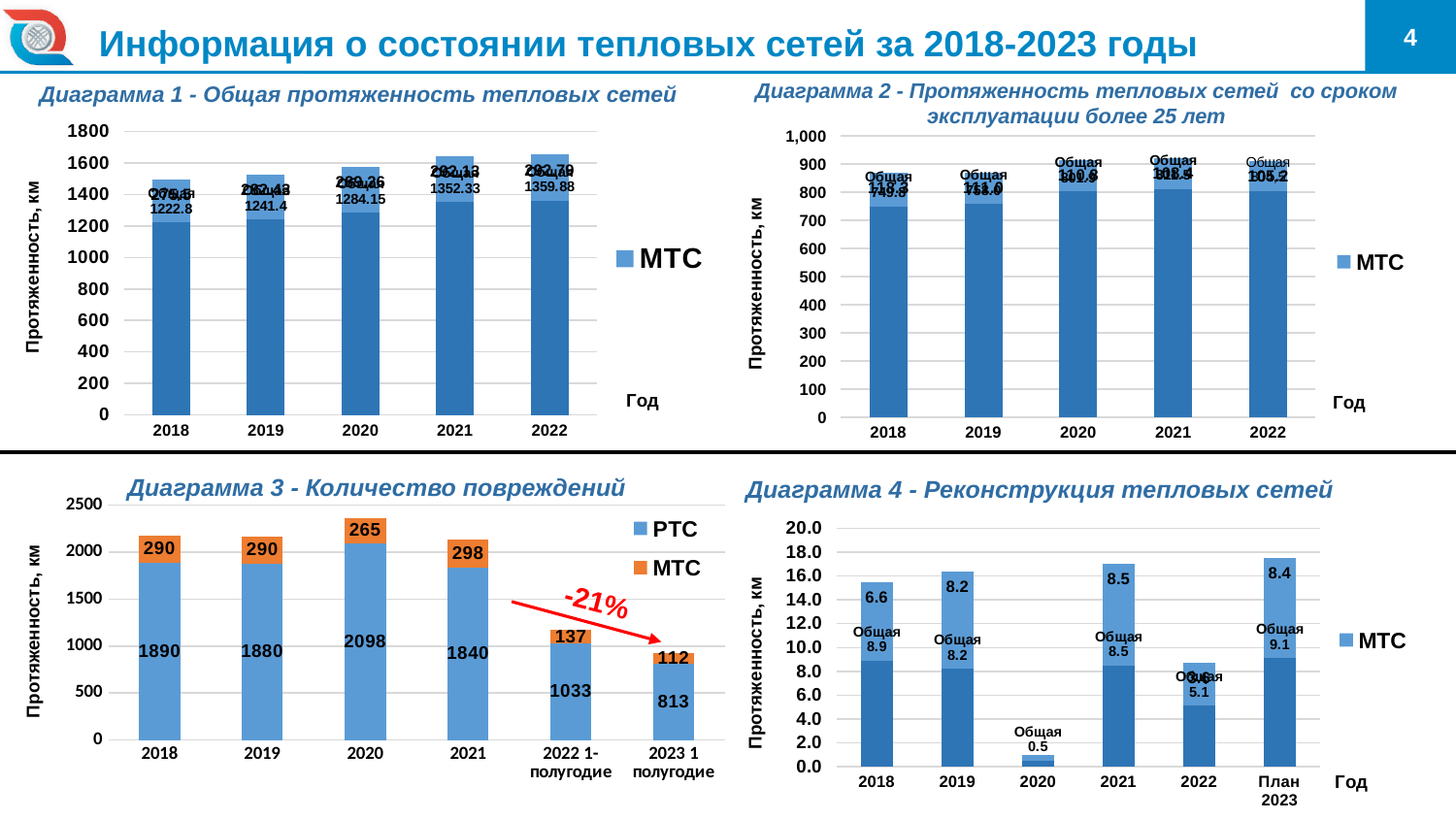
In Diagram 3 (Количество повреждений), what is the РТС value for 2020? 2098 In Diagram 3 (Количество повреждений), how many categories are shown on the x axis? 6 In Diagram 3 (Количество повреждений), what is the difference between the РТС values for 2018 and 2019? 10 In Diagram 1 (Общая протяженность тепловых сетей), do the lower data label values rise or fall from 2018 to 2022? rise In Diagram 3 (Количество повреждений), what is the МТС value for 2021? 298 In Diagram 3 (Количество повреждений), which category has the highest РТС value? 2020 In Diagram 2 (Протяженность тепловых сетей со сроком эксплуатации более 25 лет), is the bar for 2018 greater or less than 700? greater In Diagram 1 (Общая протяженность тепловых сетей), what is the lower data label value for 2021? 1352.33 In Diagram 4 (Реконструкция тепловых сетей), what is the 'Общая' value for 2020? 0.5 In Diagram 3 (Количество повреждений), how many series does the legend list? 2 In Diagram 4 (Реконструкция тепловых сетей), which category has the lowest bar? 2020 In Diagram 3 (Количество повреждений), what is the total of the stacked bar for 2018? 2180